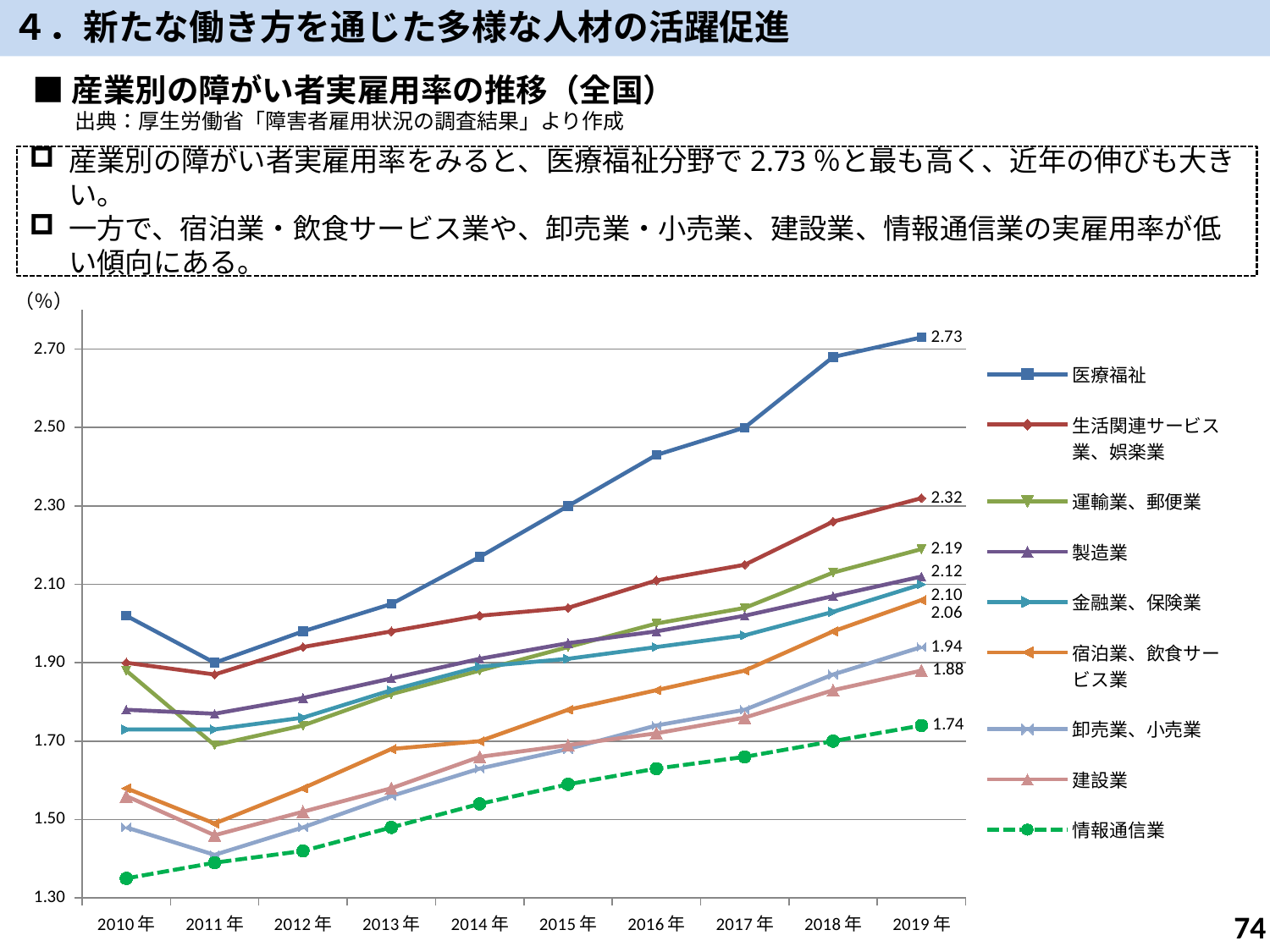
In 2019年, which is larger: 運輸業、郵便業 or 建設業? 運輸業、郵便業 What is the value for 製造業 in 2019年? 2.12 Which series has the lowest value in 2019年? 情報通信業 Does the value for 医療福祉 rise or fall from 2011年 to 2019年? rise What type of chart is shown on the slide? line chart What is the difference between the 2019年 values for 医療福祉 and 情報通信業? 0.99 What is the value for 情報通信業 in 2019年? 1.74 Is the value for 情報通信業 in 2010年 greater or less than 1.50? less Which series has the highest value in 2019年? 医療福祉 How many series does the legend list? 9 How many years are shown on the x axis? 10 What is the value for 医療福祉 in 2019年? 2.73